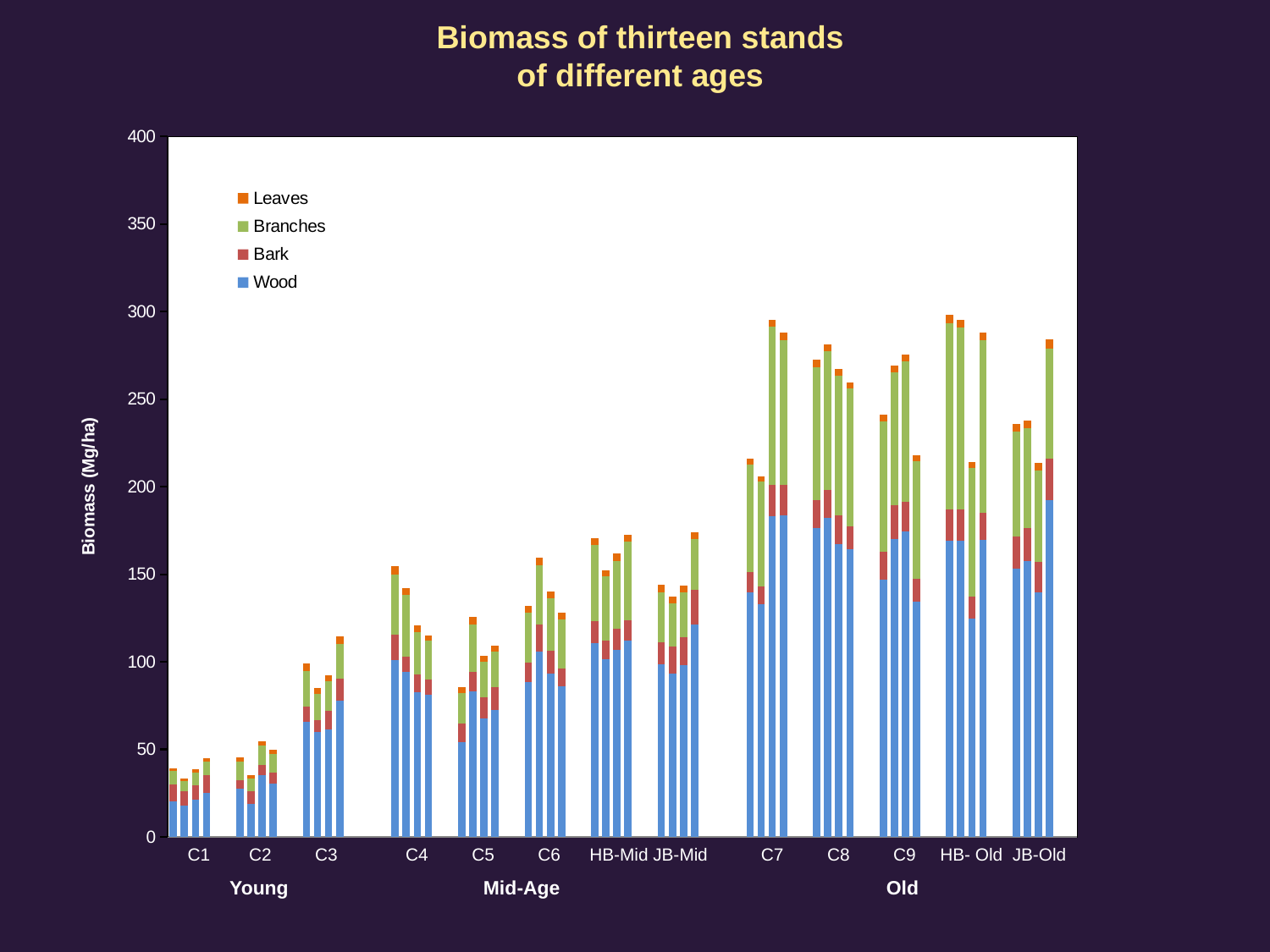
What is the title of the chart? Biomass of thirteen stands of different ages What is the label of the y axis? Biomass (Mg/ha) Do the biomass values generally rise or fall moving from the Young stands to the Old stands along the x axis? rise Is the tallest bar for C7 greater or less than 250 Mg/ha? greater What kind of chart is shown on the slide? Stacked bar chart Which stand has the lowest biomass bars? C1 Are the bars for C3 greater or less than 150 Mg/ha? less Which stand has higher biomass bars, C4 or C2? C4 Are the biomass values for the C1 bars greater or less than 50 Mg/ha? less How many stands are labelled along the x axis? 13 Which stand has higher biomass bars, C7 or C1? C7 How many series does the legend list? 4